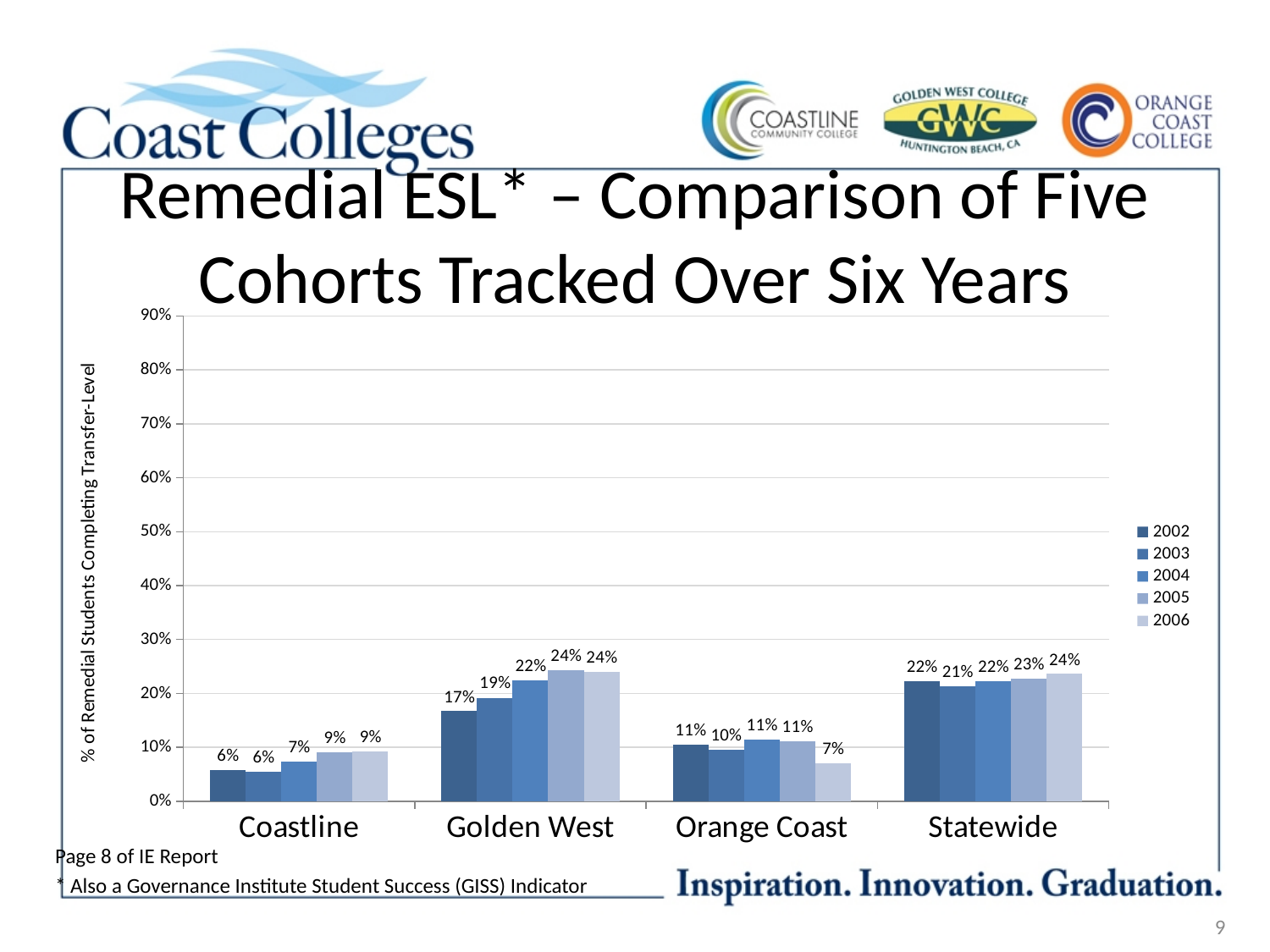
How many series does the legend list? 5 What is the value for the 2006 cohort at Orange Coast? 7% What is the label of the y axis? % of Remedial Students Completing Transfer-Level What is the value for the 2002 cohort at Golden West? 17% What is the difference between the 2006 and 2002 values at Golden West? 7% What is the value for the 2004 cohort at Coastline? 7% What kind of chart is shown on the slide? Bar chart Which is larger: the 2003 value at Orange Coast or the 2003 value at Coastline? Orange Coast How many categories are shown on the x axis? 4 What is the value for the 2005 cohort for Statewide? 23% Which cohort has the highest value at Golden West? 2005 and 2006 (24%) Which category has the lowest value for the 2002 cohort? Coastline